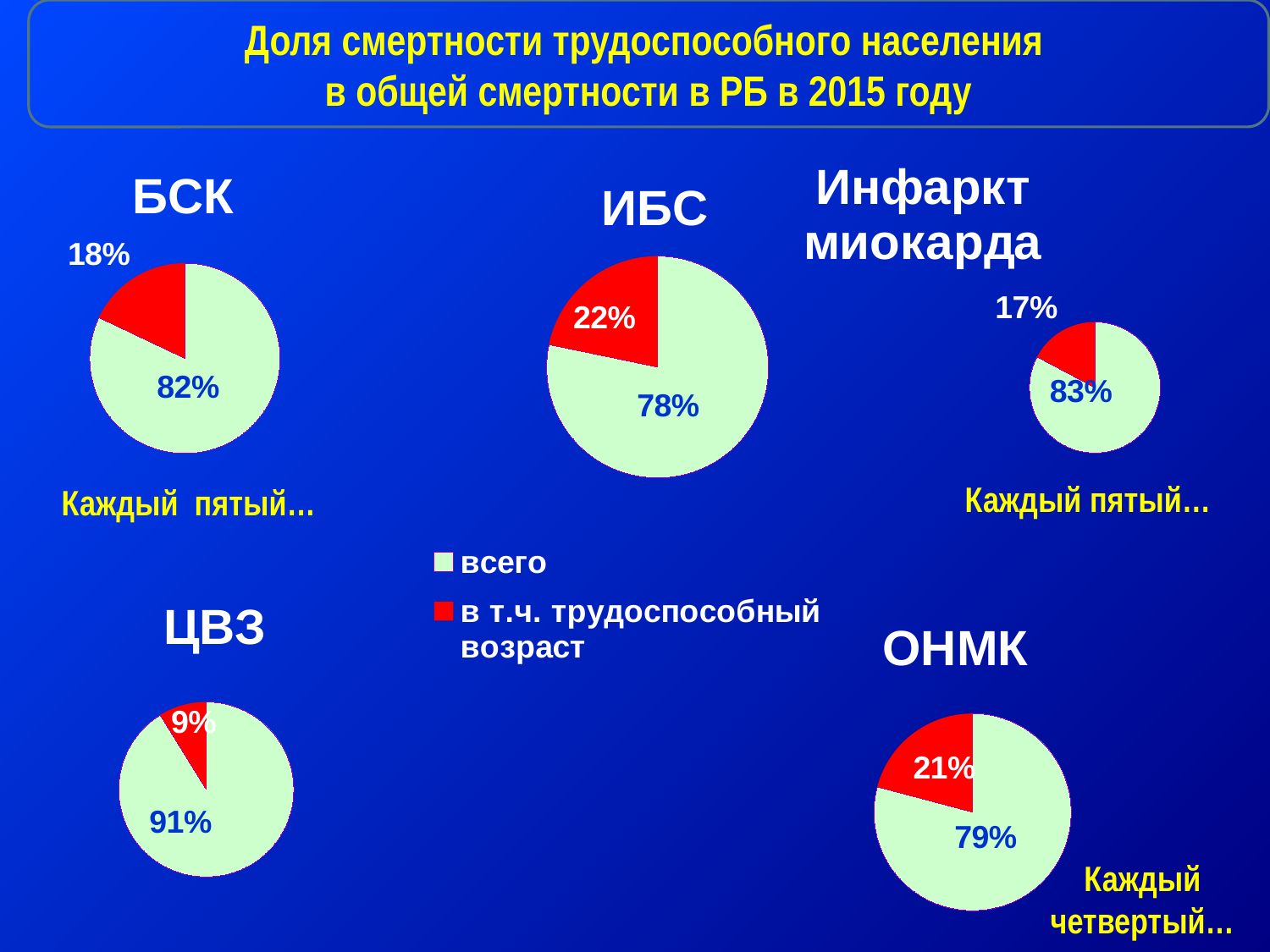
What type of chart is used for БСК, ИБС, Инфаркт миокарда, ЦВЗ and ОНМК? pie chart In the ОНМК pie chart, what percentage is shown for the green slice (всего)? 79% In the БСК pie chart, what share is labelled for the red slice (в т.ч. трудоспособный возраст)? 18% Across the five pie charts, which chart has the smallest red slice (трудоспособный возраст)? ЦВЗ How many entries does the shared legend list? 2 In the ЦВЗ pie chart, what percentage is shown for the red slice (в т.ч. трудоспособный возраст)? 9% What is the difference in percentage points between the red slice in the ОНМК chart and the red slice in the Инфаркт миокарда chart? 4 How many pie charts are shown on the slide? 5 Is the red slice in the ИБС pie chart larger or smaller than the red slice in the ЦВЗ pie chart? larger In the ИБС pie chart, what percentage is shown for the green slice (всего)? 78% Across the five pie charts, which chart has the largest red slice (трудоспособный возраст)? ИБС In the Инфаркт миокарда pie chart, what percentage is shown for the red slice? 17%